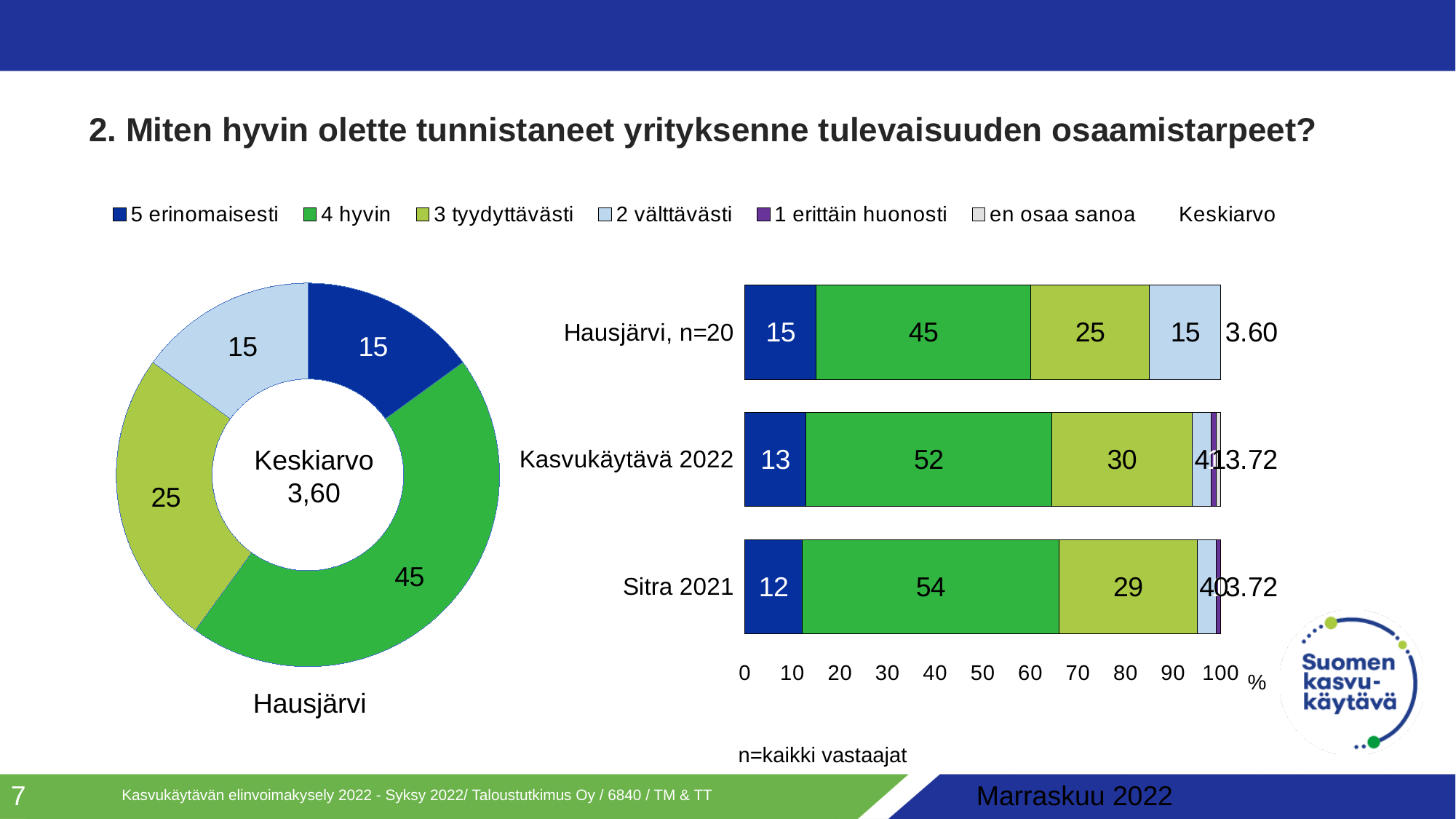
What kind of chart is shown on the right side of the slide? Stacked bar chart In the donut chart on the left, which response category has the largest slice? 4 hyvin In the bar chart on the right, which has the larger "5 erinomaisesti" value: Hausjärvi, n=20 or Sitra 2021? Hausjärvi, n=20 In the bar chart on the right, what Keskiarvo is shown for Kasvukäytävä 2022? 3.72 How many bars are shown in the bar chart on the right? 3 In the bar chart on the right, what is the value for "3 tyydyttävästi" in the Kasvukäytävä 2022 bar? 30 In the bar chart on the right, what is the value for "4 hyvin" in the Sitra 2021 bar? 54 What kind of chart is shown on the left side of the slide? Donut chart In the donut chart on the left, what percentage of Hausjärvi respondents answered "4 hyvin"? 45 In the bar chart on the right, how much larger is the "4 hyvin" value for Sitra 2021 than for Hausjärvi, n=20? 9 In the donut chart on the left, what is the Keskiarvo shown in the centre? 3,60 In the bar chart on the right, what is the value for "4 hyvin" in the Hausjärvi, n=20 bar? 45